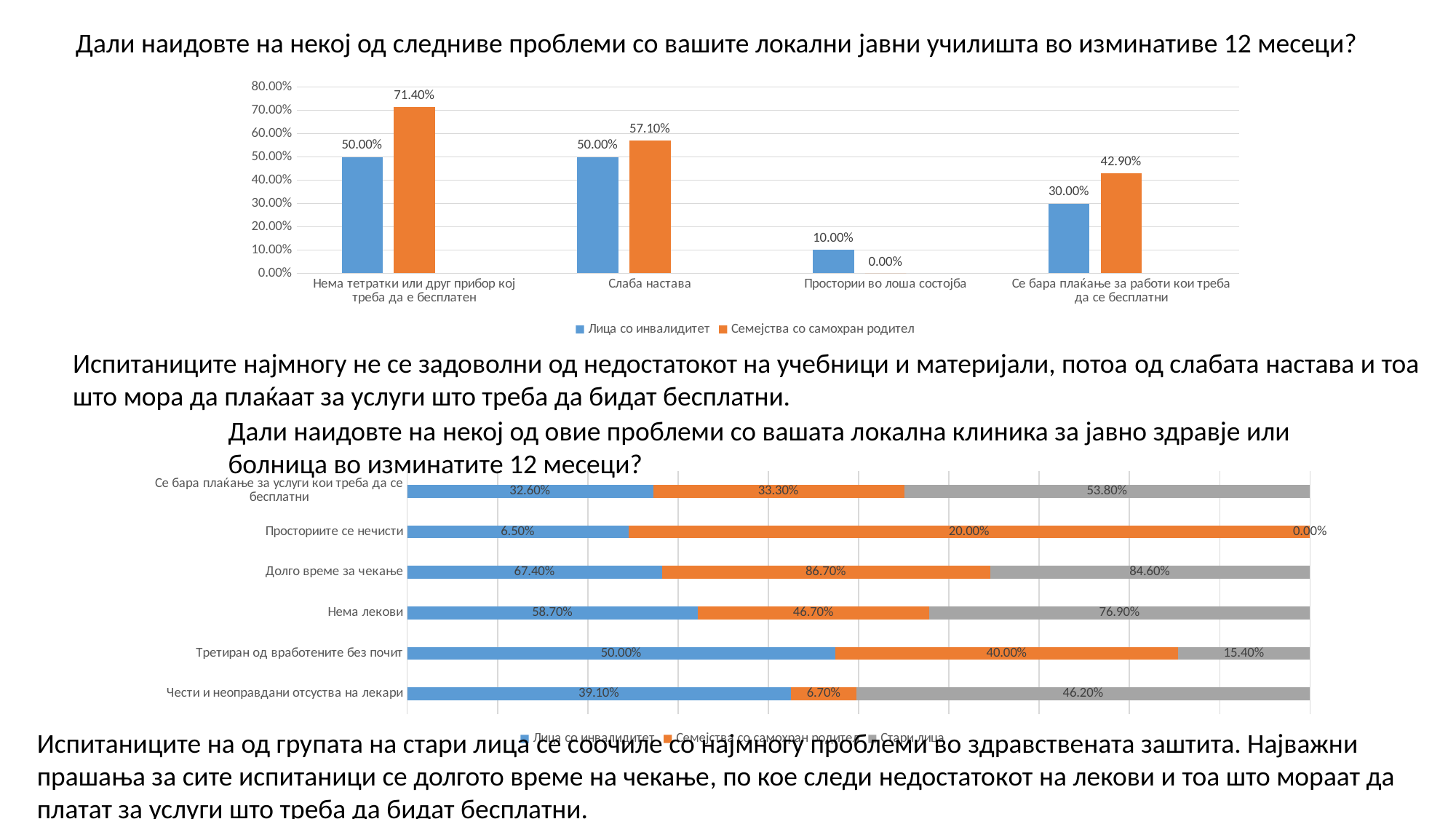
In the bottom chart, what is the value for Стари лица for Долго време за чекање? 84.60% In the bottom chart, what is the value for Лица со инвалидитет for Просториите се нечисти? 6.50% In the top chart, how many categories are shown on the x axis? 4 In the top chart, what is the value for Лица со инвалидитет for Се бара плаќање за работи кои треба да се бесплатни? 30.00% In the bottom chart, how many categories are listed on the vertical axis? 6 In the top chart, what is the difference between the two series for Слаба настава? 7.10% In the bottom chart, which is larger for Нема лекови: Лица со инвалидитет or Семејства со самохран родител? Лица со инвалидитет What kind of chart is the top chart? Bar chart In the top chart, what is the value for Семејства со самохран родител for Нема тетратки или друг прибор кој треба да е бесплатен? 71.40% In the bottom chart, which category has the highest value for Семејства со самохран родител? Долго време за чекање How many series does the legend of the bottom chart list? 3 In the top chart, which category has the lowest value for Семејства со самохран родител? Простории во лоша состојба